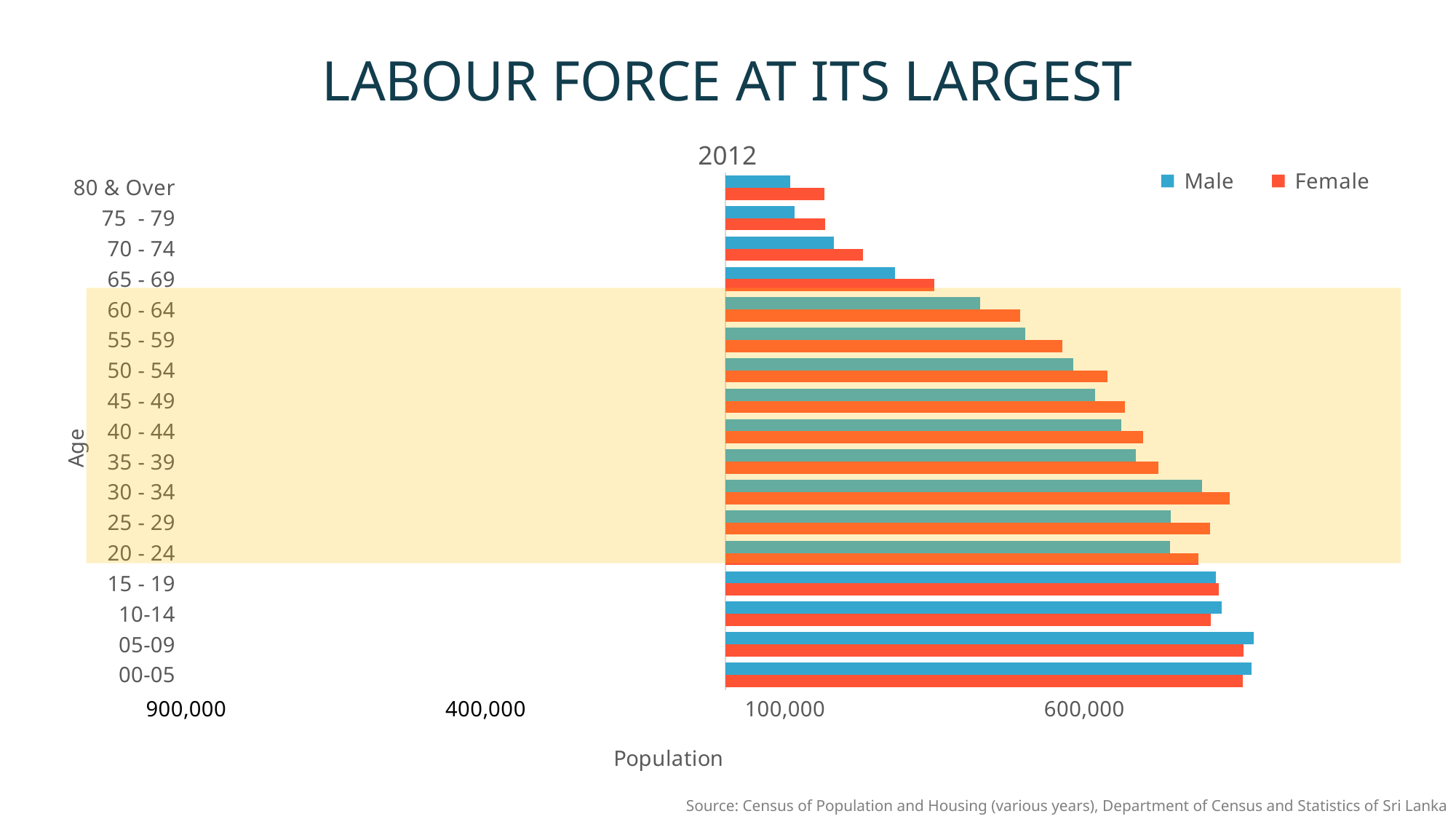
Is the Female value for the 45 - 49 age group greater or less than 600,000? greater Is the Male value for the 60 - 64 age group greater or less than 600,000? less How many series does the legend list? 2 How many age groups are plotted on the chart? 17 Do the Male bars generally get longer or shorter as the age group increases from 00-05 to 80 & Over? Shorter What year is shown as the chart's title above the bars? 2012 Is the Male value for the 30 - 34 age group greater or less than 600,000? greater For the 30 - 34 age group, which is larger, the Male or the Female value? Female For the 65 - 69 age group, which is larger, the Male or the Female value? Female What kind of chart is shown on the slide? Bar chart